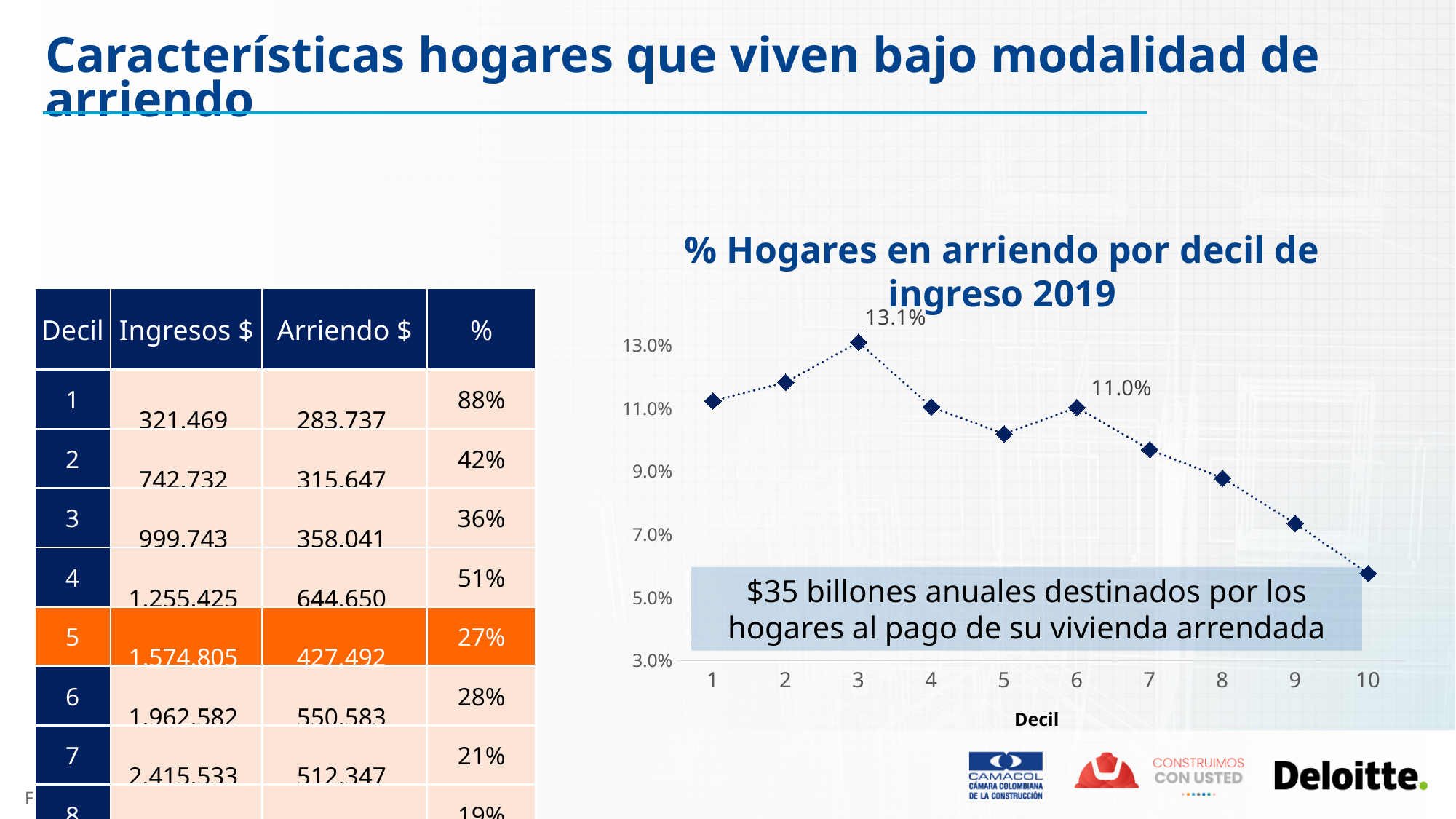
Which has a higher value in the chart, decil 3 or decil 6? Decil 3 Do the values rise or fall from decil 6 to decil 10 in the chart? Fall Which decil has the highest percentage of households renting in the chart? 3 What is the value for decil 6 in the chart? 11.0% What is the difference between the values for decil 3 and decil 6 in the chart? 2.1 percentage points What is the value for decil 3 in the chart '% Hogares en arriendo por decil de ingreso 2019'? 13.1% How many deciles are plotted on the x axis of the chart? 10 Is the value for decil 2 greater or less than 11.0%? greater Which decil has the lowest percentage of households renting in the chart? 10 Is the value for decil 10 greater or less than 7.0%? less What kind of chart is '% Hogares en arriendo por decil de ingreso 2019'? Line chart Is the value for decil 8 greater or less than 7.0%? greater